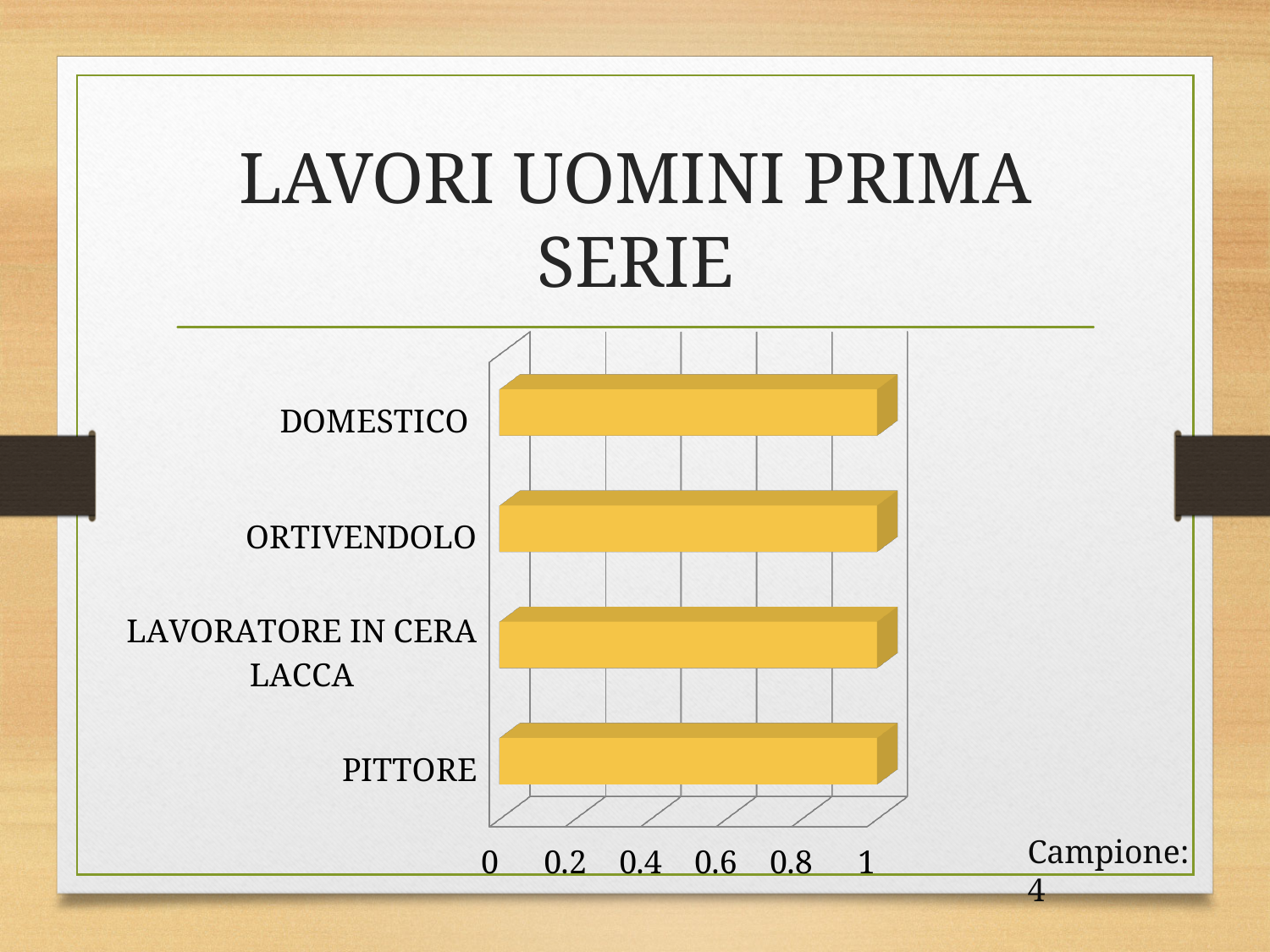
Is the value for LAVORATORE IN CERA LACCA greater or less than 0.8? greater What is the title of the chart on the slide? LAVORI UOMINI PRIMA SERIE What is the value for PITTORE? 1 Is the value for DOMESTICO greater or less than 0.8? greater What is the value for DOMESTICO? 1 Is the value for PITTORE greater or less than 0.6? greater What kind of chart is shown on the slide? bar chart How many categories are shown in the chart? 4 Which category is listed at the top of the chart? DOMESTICO What is the highest value shown on the horizontal axis? 1